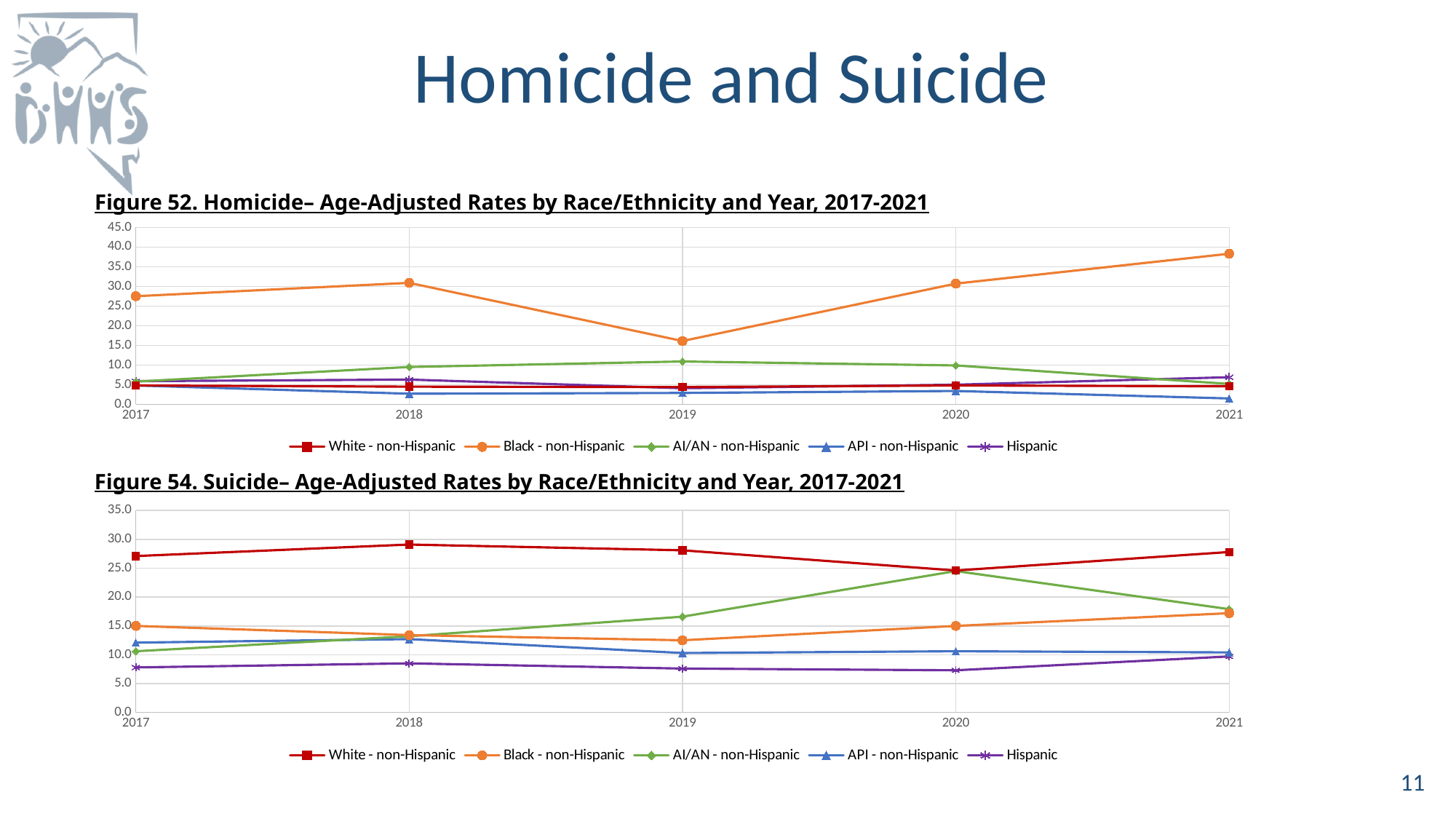
In Figure 54 (Suicide), does the AI/AN - non-Hispanic rate rise or fall from 2017 to 2020? rise What kind of chart is Figure 52 (Homicide)? line chart In Figure 52 (Homicide), which race/ethnicity group has the lowest rate in 2021? API - non-Hispanic How many series does the legend of Figure 52 (Homicide) list? 5 In Figure 54 (Suicide), which race/ethnicity group has the highest rate in 2017? White - non-Hispanic In Figure 52 (Homicide), is the 2021 value for Black - non-Hispanic greater or less than 35.0? greater In Figure 52 (Homicide), which is larger in 2018: Black - non-Hispanic or AI/AN - non-Hispanic? Black - non-Hispanic How many years are shown on the x axis of Figure 52 (Homicide)? 5 In Figure 54 (Suicide), which race/ethnicity group has the lowest rate in 2017? Hispanic In Figure 54 (Suicide), is the 2018 value for White - non-Hispanic greater or less than 25.0? greater In Figure 52 (Homicide), is the 2019 value for Black - non-Hispanic greater or less than 20.0? less In Figure 52 (Homicide), which race/ethnicity group has the highest rate in 2021? Black - non-Hispanic